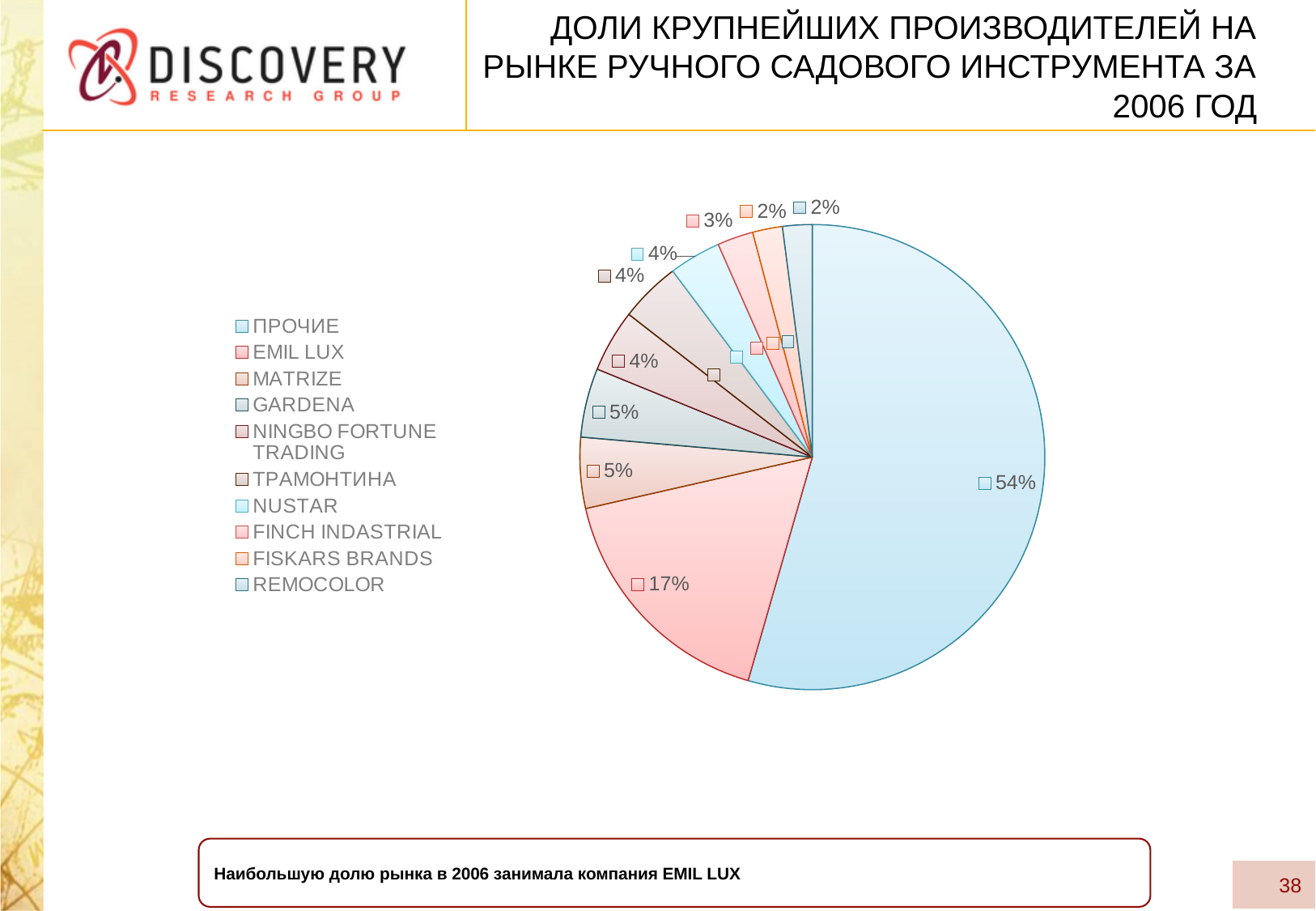
Which year does the chart title say the market shares refer to? 2006 What share of the market does ПРОЧИЕ hold in the pie chart? 54% How many categories are listed in the legend of the pie chart? 10 Which has a larger share, EMIL LUX or MATRIZE? EMIL LUX What is the combined share of EMIL LUX and MATRIZE? 22% Which category has the largest slice of the pie? ПРОЧИЕ What share is shown for FISKARS BRANDS? 2% How many percentage points larger is the ПРОЧИЕ slice than the EMIL LUX slice? 37 What share is shown for FINCH INDASTRIAL? 3% What share of the market does EMIL LUX hold? 17% What share is shown for NUSTAR? 4% What type of chart is shown on the slide? pie chart